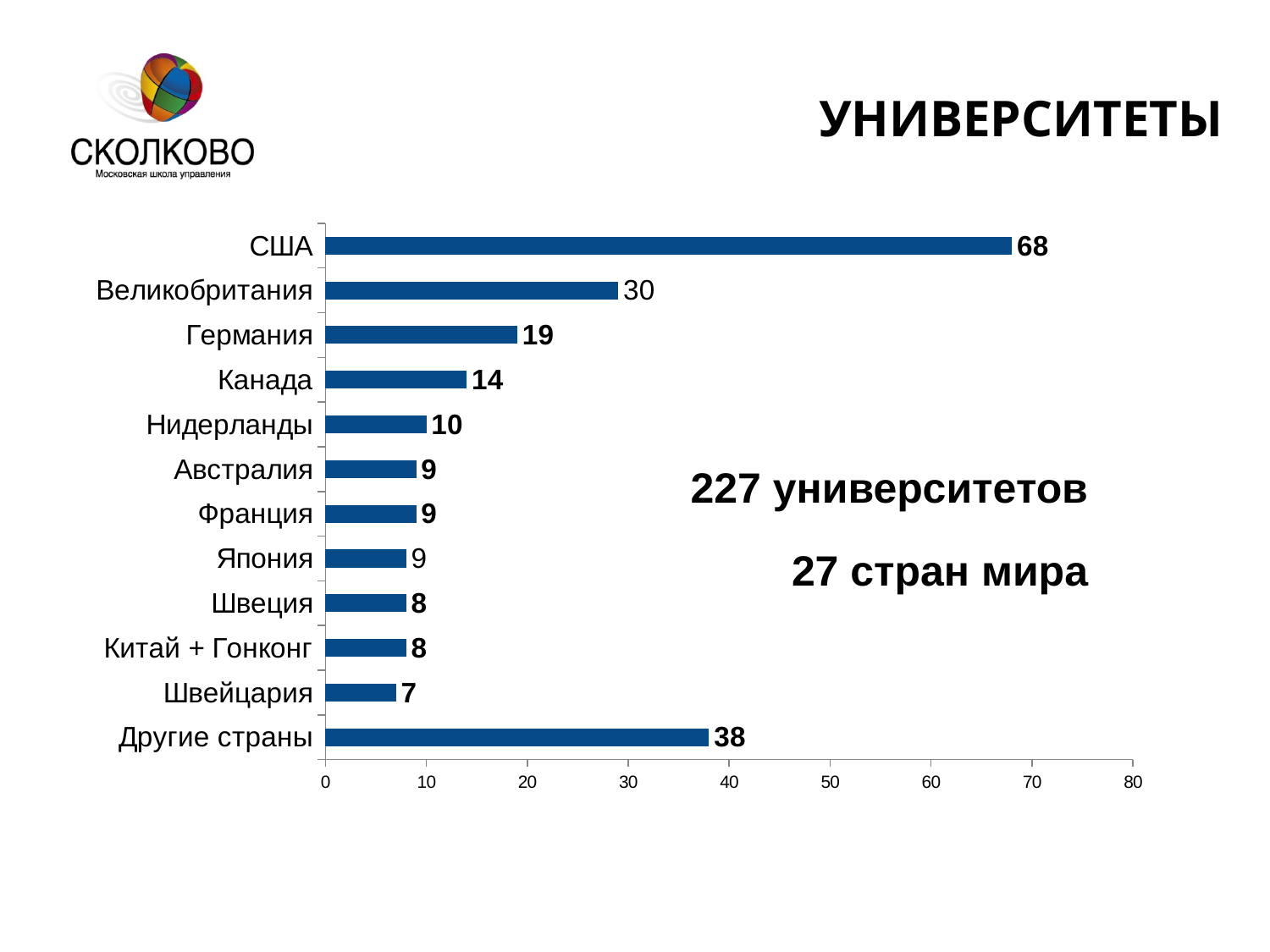
What is the difference between the values for США and Великобритания? 38 What is the value for Другие страны? 38 What is the title of the slide? УНИВЕРСИТЕТЫ Which category has the highest value? США What kind of chart is shown on the slide? bar chart Which category has the lowest value? Швейцария Which is larger, the value for Другие страны or the value for Великобритания? Другие страны What is the value for Великобритания? 30 How many categories are shown in the chart? 12 What is the value for Нидерланды? 10 What is the value for США? 68 What is the difference between the values for Германия and Канада? 5